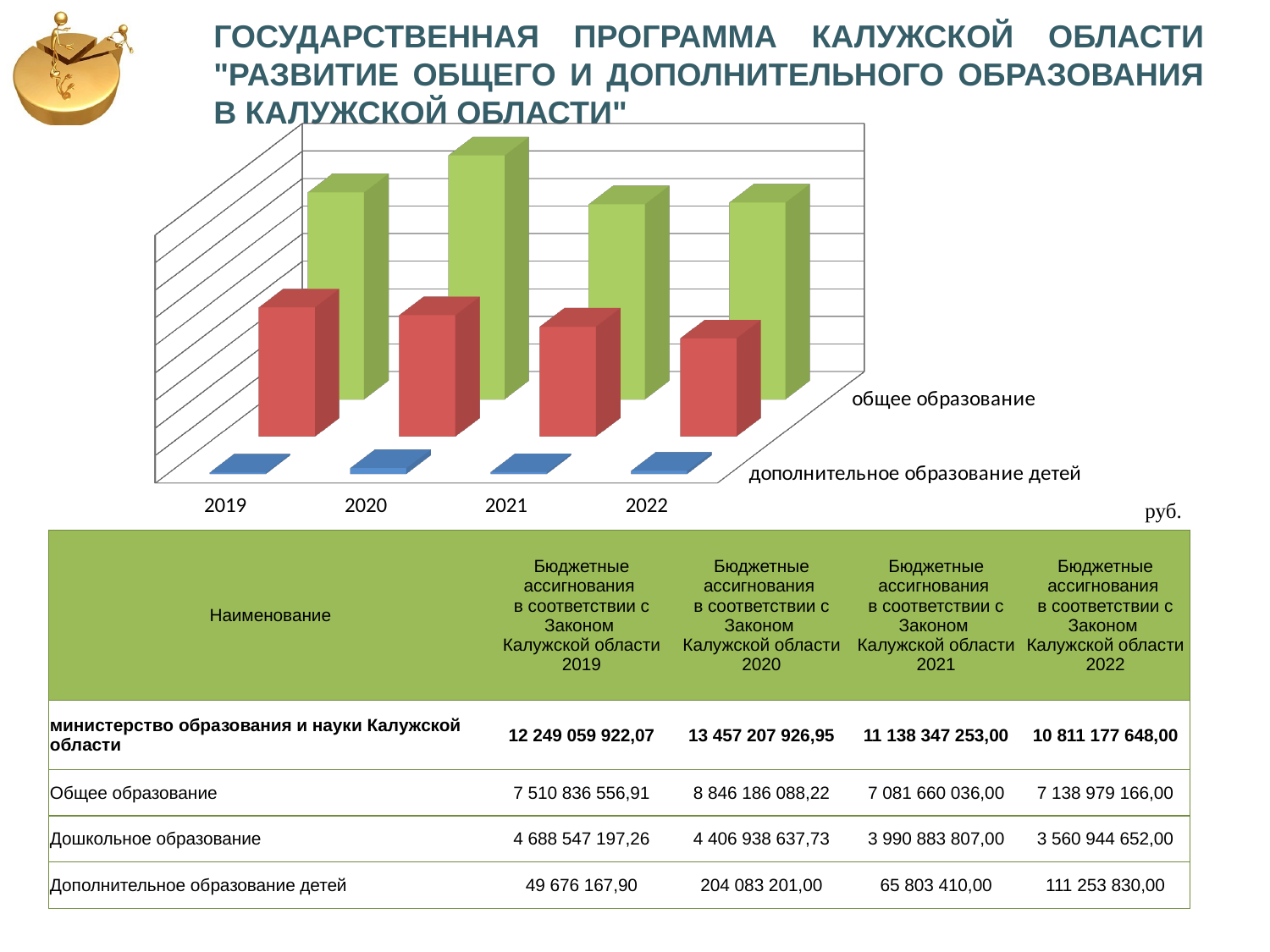
Which is larger for общее образование: the bar for 2020 or the bar for 2021? 2020 How many years are shown on the x axis of the chart? 4 Which labelled series has the tallest bars in the chart? общее образование What colour are the bars for общее образование? green Does the bar for общее образование rise or fall from 2020 to 2021? falls Which labelled series has the smallest bars in the chart? дополнительное образование детей What is the first year shown on the x axis of the chart? 2019 Which is larger for общее образование: the bar for 2019 or the bar for 2020? 2020 In which year is the bar for общее образование the tallest? 2020 Does the bar for общее образование rise or fall from 2019 to 2020? rises What kind of chart is shown on the slide? bar chart